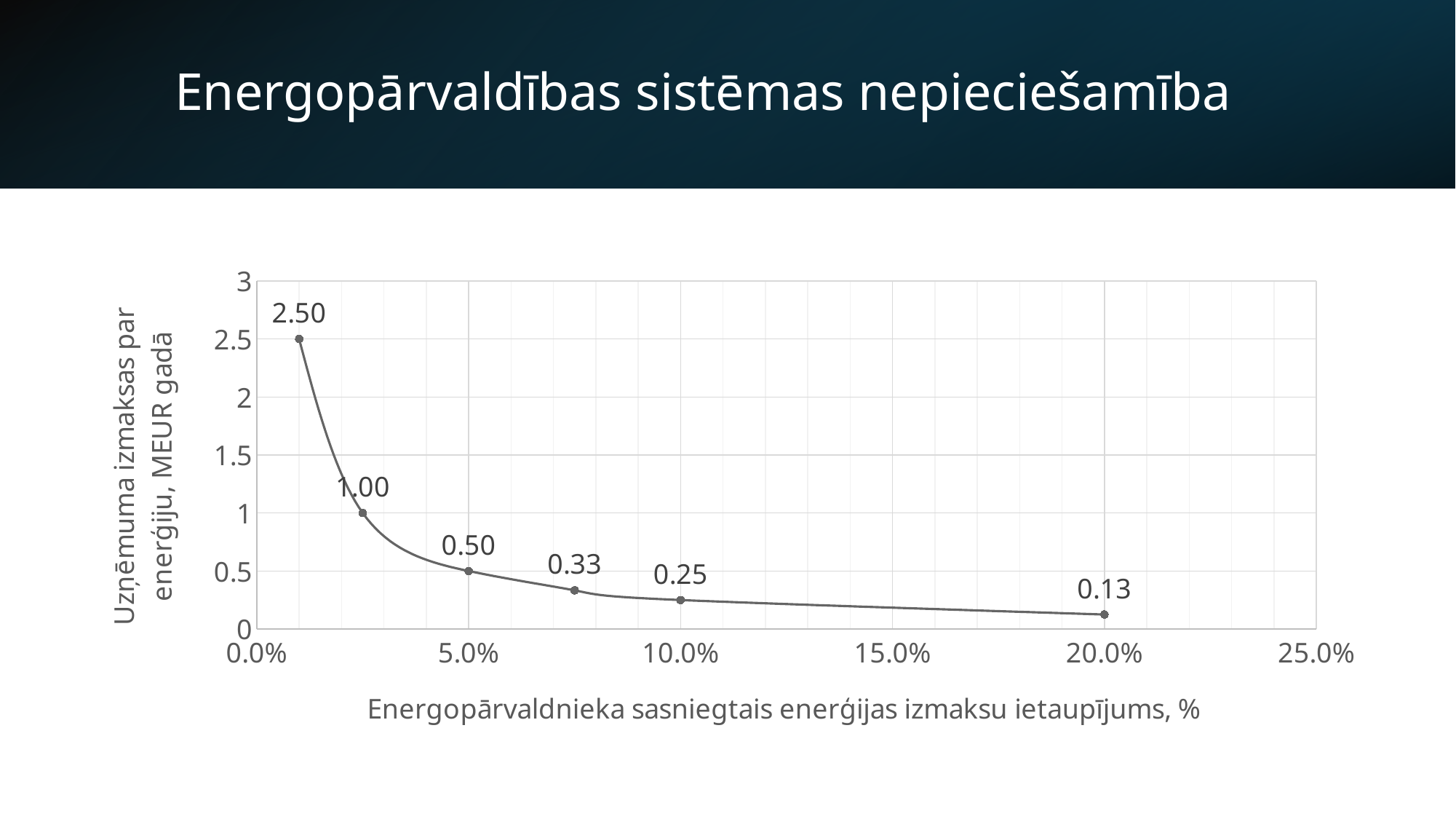
What is the plotted value at 20.0% on the x axis? 0.13 What is the plotted value at 5.0% on the x axis? 0.50 What kind of chart is shown on the slide? line chart What is the plotted value at 10.0% on the x axis? 0.25 How many data points are plotted on the chart? 6 Which has the larger value, the point at 5.0% or the point at 10.0%? 5.0% What is the difference between the two highest labelled values, 2.50 and 1.00? 1.50 What is the lowest data label shown on the chart? 0.13 Do the plotted values rise or fall as the x-axis percentage increases? fall What is the title of the x axis? Energopārvaldnieka sasniegtais enerģijas izmaksu ietaupījums, % What is the highest data label shown on the chart? 2.50 What is the difference between the values at 5.0% and 10.0%? 0.25